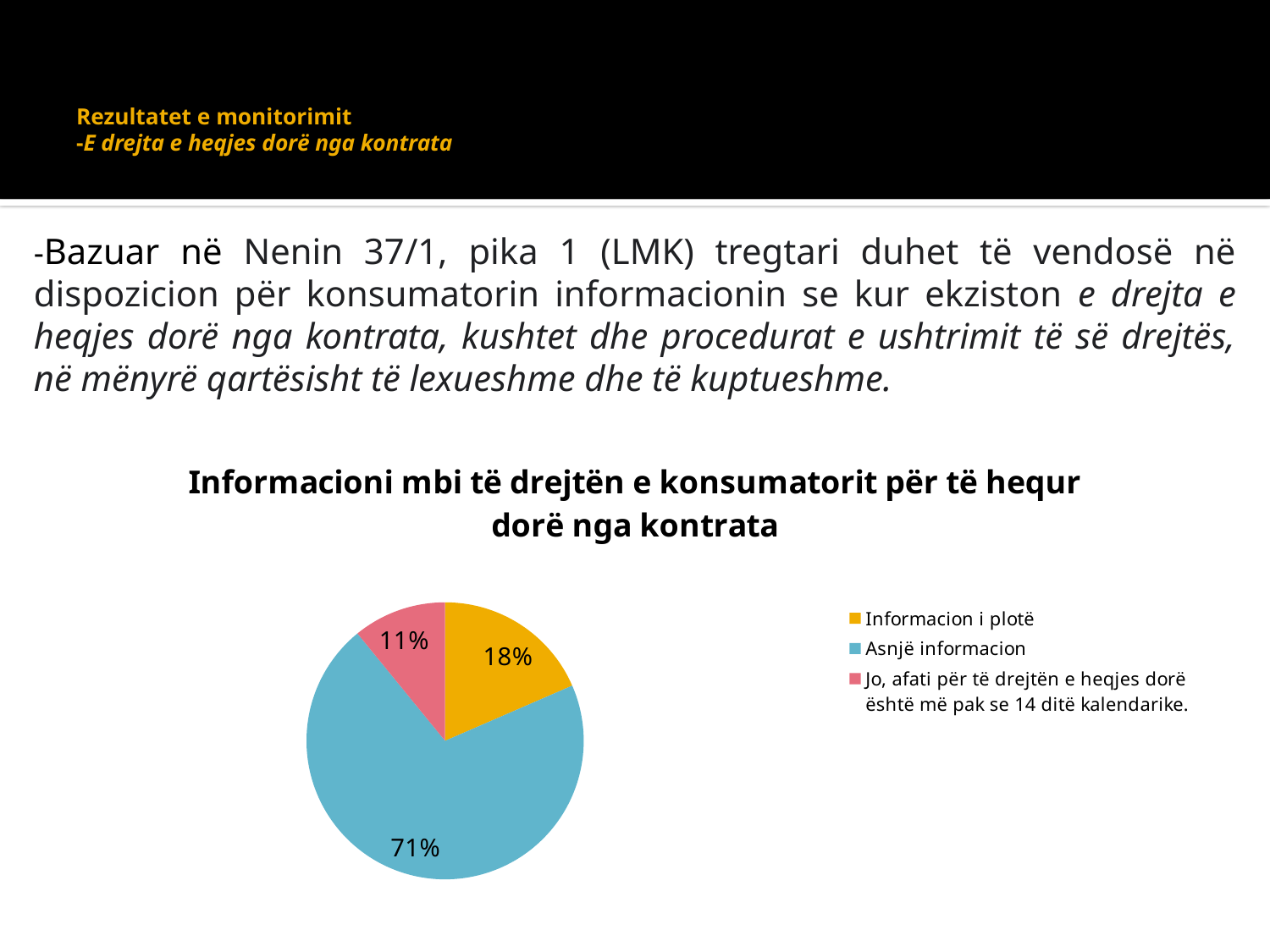
What share of the pie does "Informacion i plotë" represent? 18% How many entries does the legend list? 3 Which is larger: the share for "Informacion i plotë" or the share for "Jo, afati për të drejtën e heqjes dorë është më pak se 14 ditë kalendarike."? Informacion i plotë What is the title of the chart? Informacioni mbi të drejtën e konsumatorit për të hequr dorë nga kontrata What kind of chart is shown on the slide? pie chart What share of the pie does "Jo, afati për të drejtën e heqjes dorë është më pak se 14 ditë kalendarike." represent? 11% What share of the pie does "Asnjë informacion" represent? 71% Which category has the largest slice of the pie? Asnjë informacion How many slices does the pie chart have? 3 Which category has the smallest slice of the pie? Jo, afati për të drejtën e heqjes dorë është më pak se 14 ditë kalendarike. What colour is the slice for "Asnjë informacion"? blue What is the difference between the shares for "Asnjë informacion" and "Informacion i plotë"? 53%